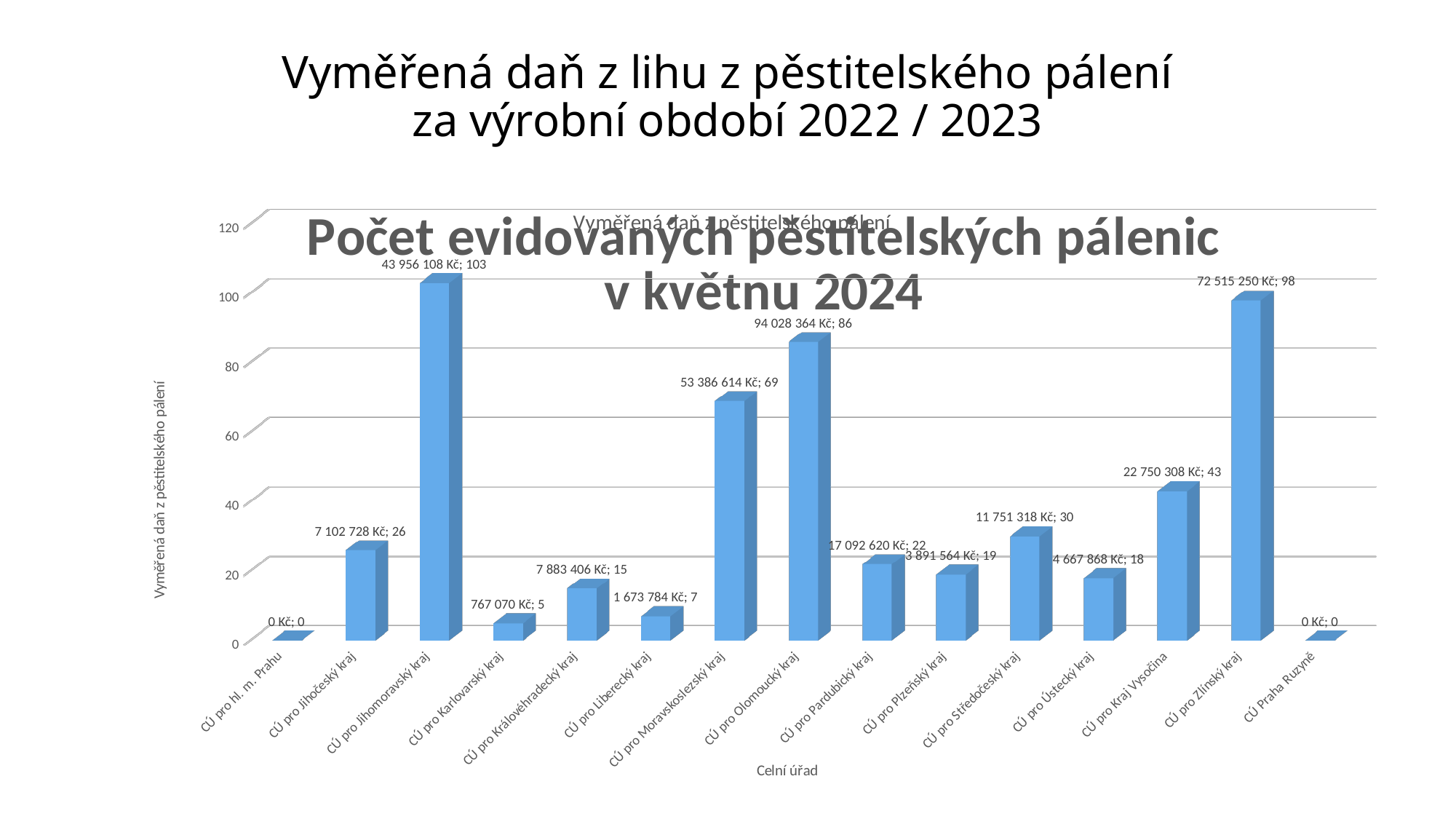
What is the title of the horizontal axis of the chart? Celní úřad What data label is shown for CÚ pro Jihomoravský kraj? 43 956 108 Kč; 103 How many customs offices (categories) are shown on the x axis of the chart? 15 What is the difference between the count shown for CÚ pro Jihomoravský kraj (103) and the count for CÚ pro Zlínský kraj (98)? 5 What kind of chart is shown on the slide? bar chart Which customs office has the highest tax amount (Kč) shown in its data label? CÚ pro Olomoucký kraj What data label is shown for CÚ pro Olomoucký kraj? 94 028 364 Kč; 86 Which customs office has the tallest bar in the chart? CÚ pro Jihomoravský kraj Is the bar for CÚ pro Kraj Vysočina greater or less than 40 on the vertical axis? greater What data label is shown for CÚ pro Kraj Vysočina? 22 750 308 Kč; 43 Which bar is taller: CÚ pro Moravskoslezský kraj or CÚ pro Středočeský kraj? CÚ pro Moravskoslezský kraj What data label is shown for CÚ pro Karlovarský kraj? 767 070 Kč; 5